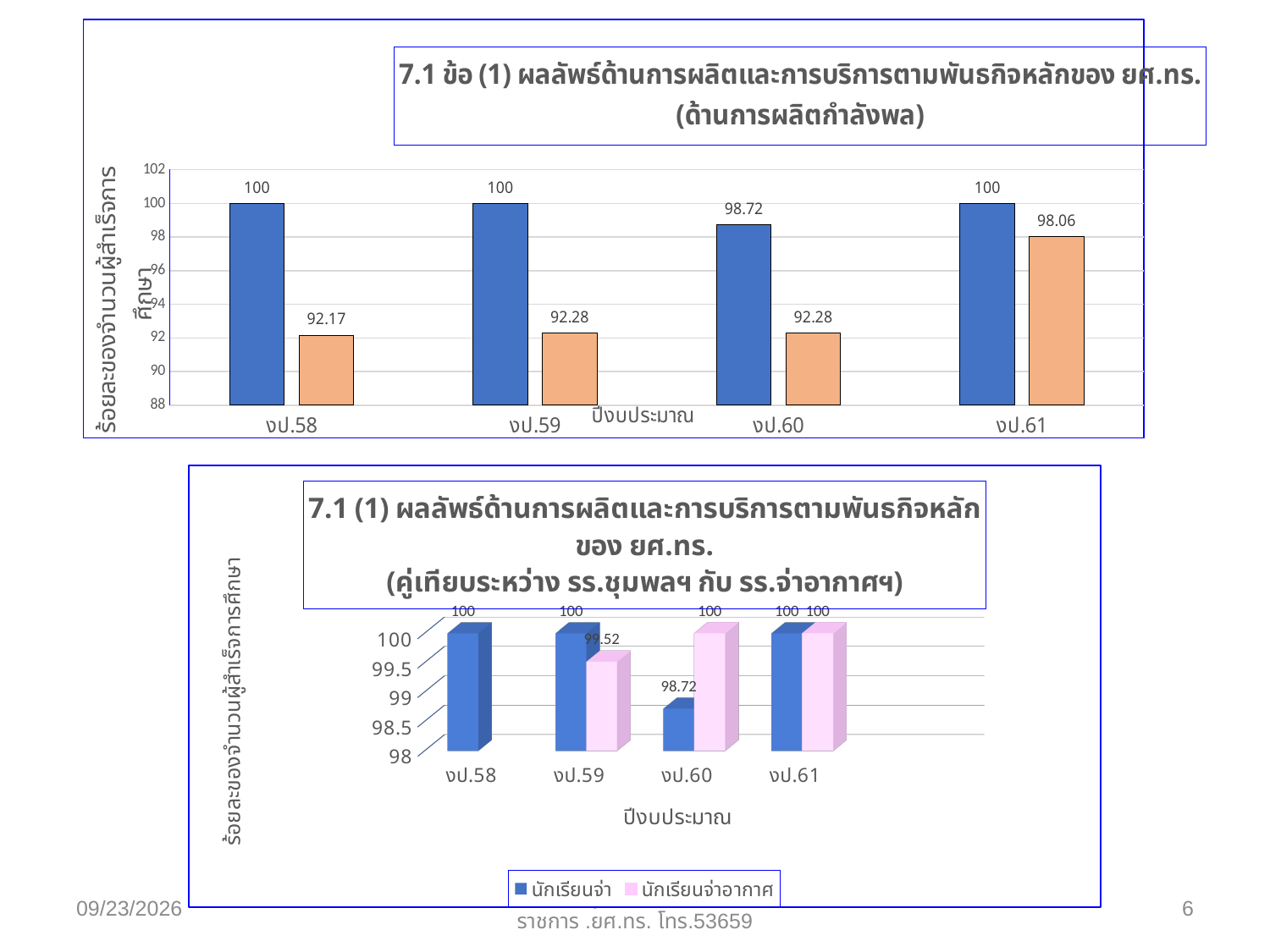
In the bottom chart, what is the value for นักเรียนจ่าอากาศ in งป.59? 99.52 What kind of chart is the bottom chart? bar chart In the top chart, how many years are shown on the x axis? 4 In the top chart, what is the value of the blue bar for งป.60? 98.72 In the top chart, what is the value of the orange bar for งป.61? 98.06 In the top chart, which year has the lowest orange bar? งป.58 In the top chart, what is the difference between the blue and orange bars for งป.59? 7.72 How many series does the legend of the bottom chart list? 2 In the top chart, what is the value of the orange bar for งป.58? 92.17 In the bottom chart, what is the value for นักเรียนจ่า in งป.60? 98.72 In the top chart, is the orange bar for งป.61 greater or less than 96? greater In the bottom chart, which is larger in งป.60, นักเรียนจ่า or นักเรียนจ่าอากาศ? นักเรียนจ่าอากาศ